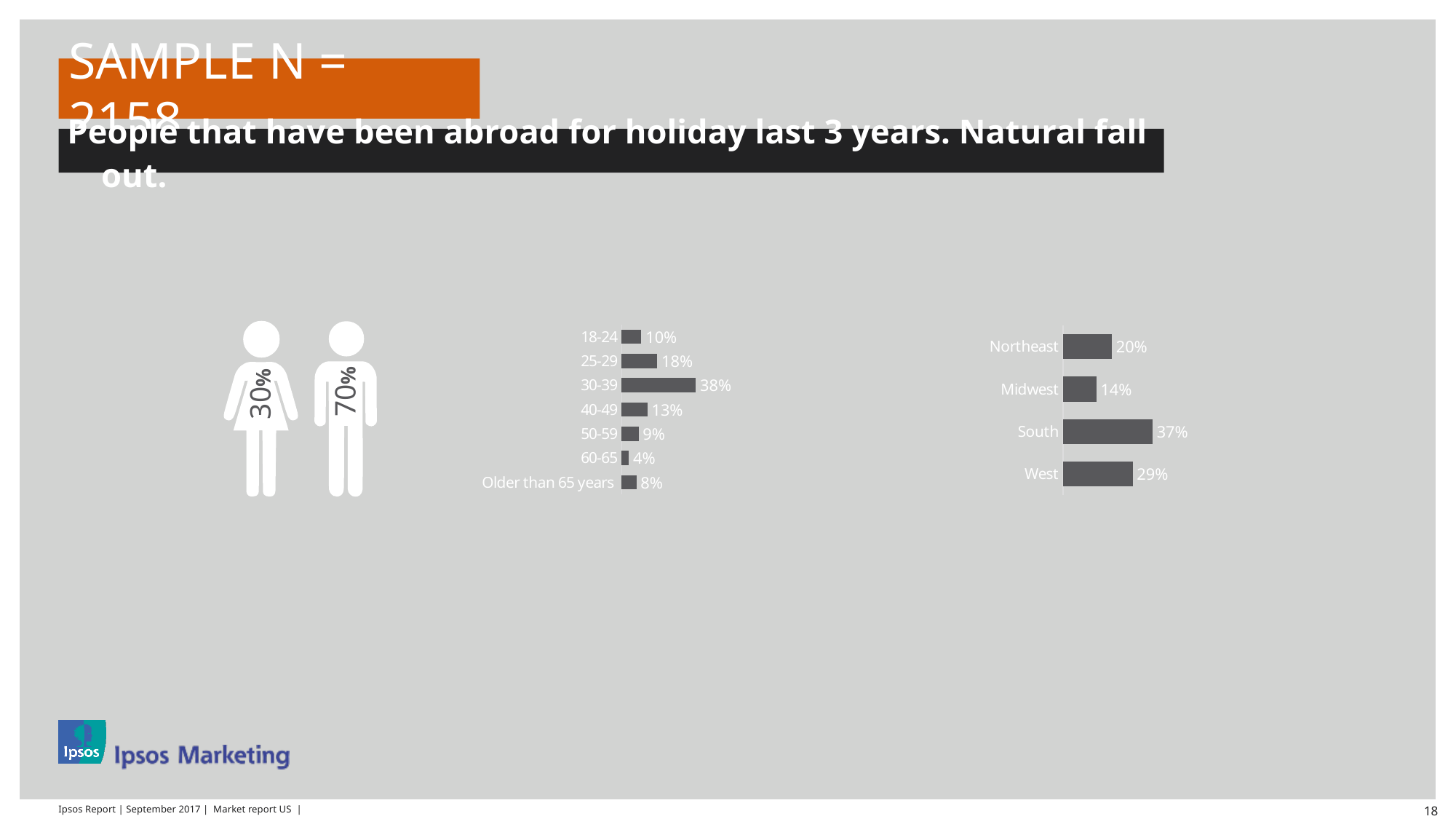
What kind of chart is the region chart on the right of the slide? Bar chart In the age group bar chart in the middle of the slide, how many age categories are shown? 7 In the age group bar chart in the middle of the slide, which age group has the highest value? 30-39 In the region bar chart on the right of the slide, what is the value for Midwest? 14% In the age group bar chart in the middle of the slide, which age group has the lowest value? 60-65 In the age group bar chart in the middle of the slide, what is the value for Older than 65 years? 8% In the region bar chart on the right of the slide, which is larger, West or Northeast? West In the age group bar chart in the middle of the slide, what is the value for 30-39? 38% In the age group bar chart in the middle of the slide, what is the difference between the values for 25-29 and 18-24? 8% In the region bar chart on the right of the slide, how many regions are shown? 4 In the region bar chart on the right of the slide, what is the difference between South and West? 8% In the region bar chart on the right of the slide, which region has the highest value? South